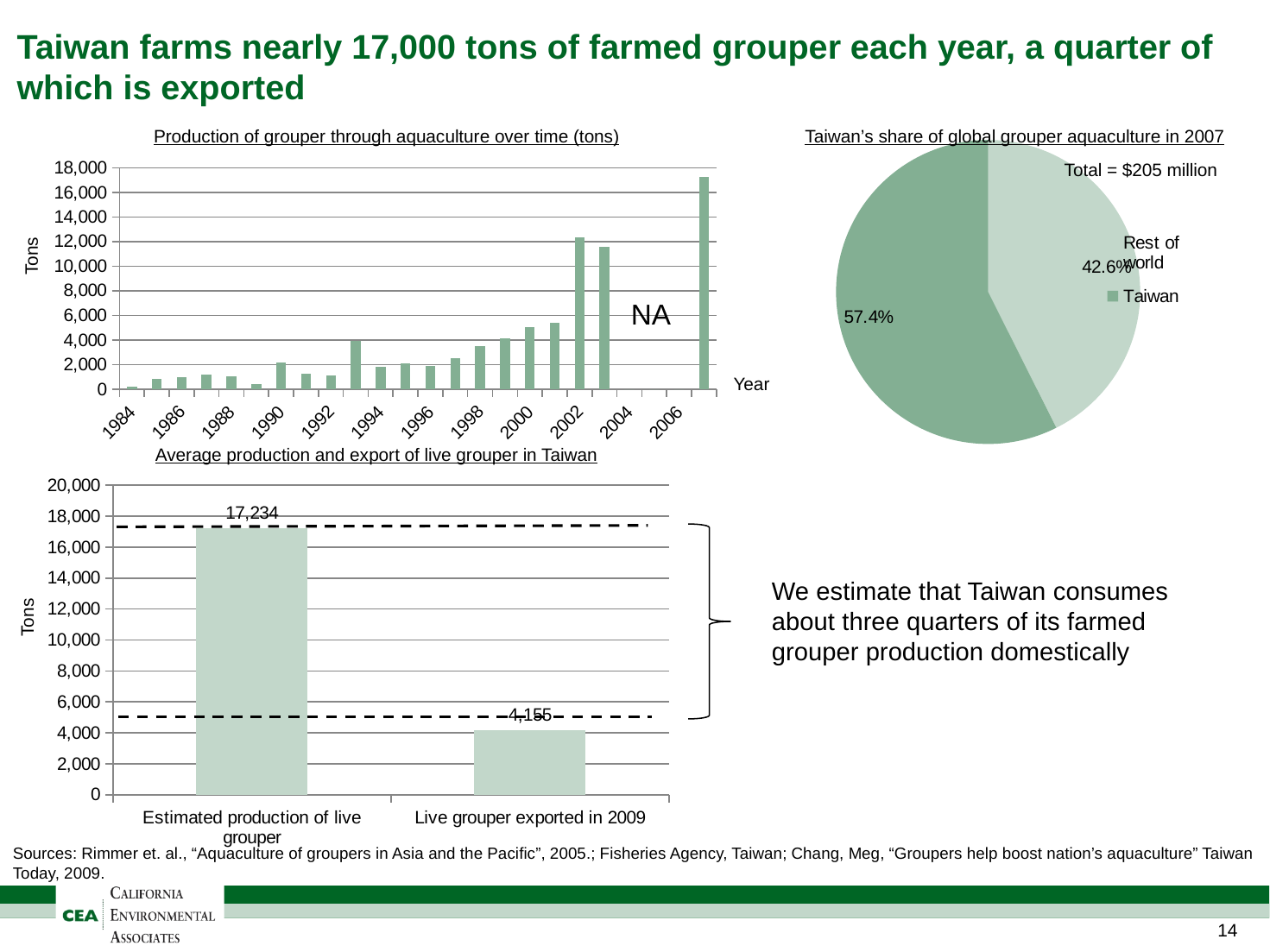
In the pie chart 'Taiwan's share of global grouper aquaculture in 2007', what share does Taiwan hold? 57.4% In the chart 'Average production and export of live grouper in Taiwan', what is the value for 'Live grouper exported in 2009'? 4,155 How many entries does the legend of the pie chart 'Taiwan's share of global grouper aquaculture in 2007' list? 2 In the pie chart 'Taiwan's share of global grouper aquaculture in 2007', what share does the Rest of world hold? 42.6% In the pie chart 'Taiwan's share of global grouper aquaculture in 2007', which slice is larger, Taiwan or Rest of world? Taiwan In the chart 'Average production and export of live grouper in Taiwan', what is the difference between the estimated production and the live grouper exported in 2009? 13,079 What total value is stated on the pie chart 'Taiwan's share of global grouper aquaculture in 2007'? $205 million In the chart 'Average production and export of live grouper in Taiwan', how many bars are plotted? 2 In the chart 'Production of grouper through aquaculture over time (tons)', is the value for 1994 greater or less than 6,000? less In the chart 'Average production and export of live grouper in Taiwan', what is the value for 'Estimated production of live grouper'? 17,234 In the chart 'Production of grouper through aquaculture over time (tons)', is the value for 2002 greater or less than 10,000? greater What kind of chart is 'Production of grouper through aquaculture over time (tons)'? Bar chart